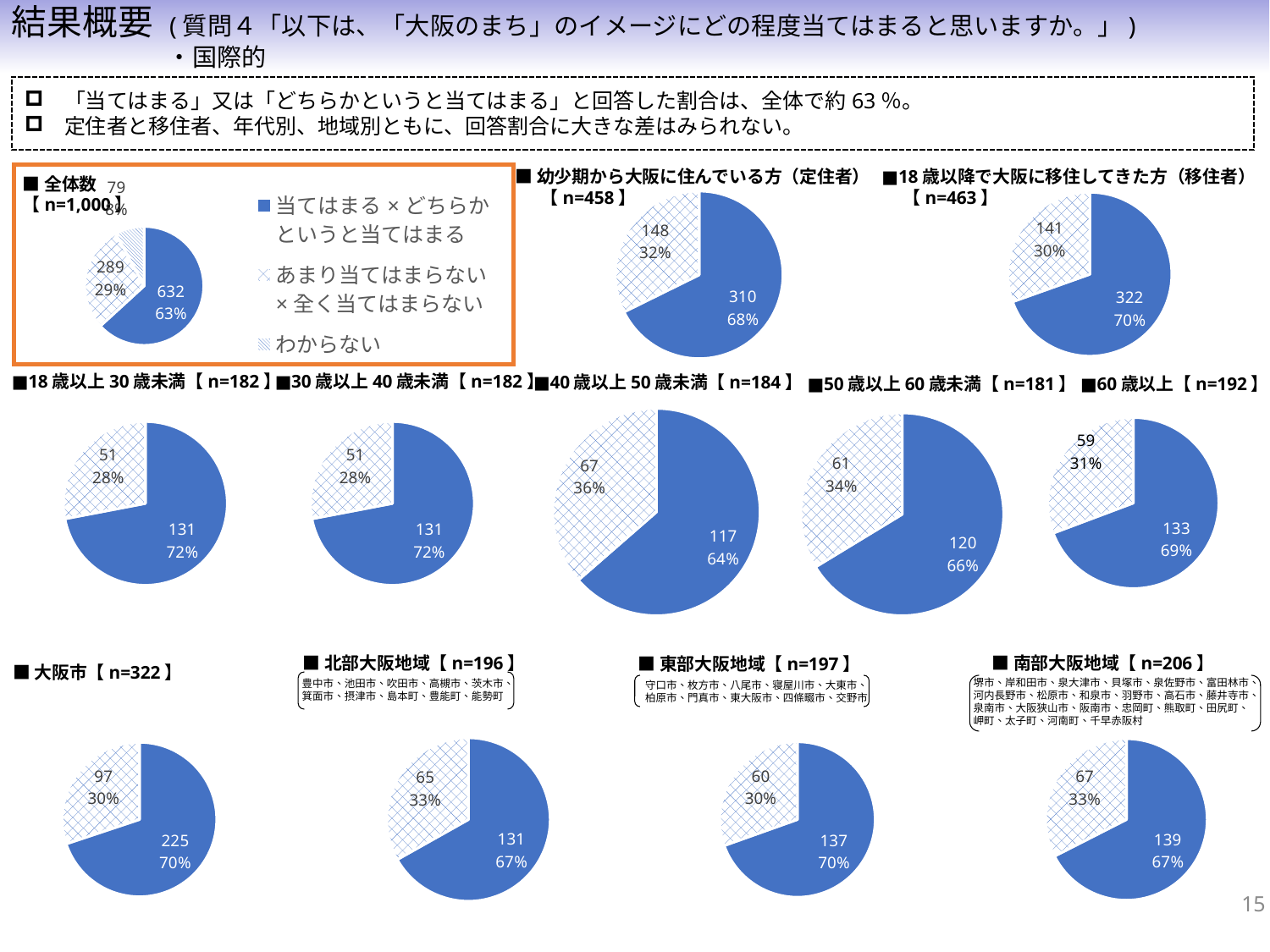
In the 幼少期から大阪に住んでいる方（定住者）【n=458】 pie chart, what percentage is shown for あまり当てはまらない × 全く当てはまらない? 32% What kind of chart is used for the 60歳以上【n=192】 data? Pie chart In the 60歳以上【n=192】 pie chart, which slice is the largest? 当てはまる × どちらかというと当てはまる In the 全体数【n=1,000】 pie chart, what is the count for 当てはまる × どちらかというと当てはまる? 632 In the 40歳以上50歳未満【n=184】 pie chart, what percentage is shown for the 当てはまる × どちらかというと当てはまる slice? 64% In the 南部大阪地域【n=206】 pie chart, what is the count for あまり当てはまらない × 全く当てはまらない? 67 Which pie chart shows the larger 当てはまる × どちらかというと当てはまる percentage: 18歳以上30歳未満【n=182】 or 40歳以上50歳未満【n=184】? 18歳以上30歳未満【n=182】 In the 18歳以降で大阪に移住してきた方（移住者）【n=463】 pie chart, what is the count for 当てはまる × どちらかというと当てはまる? 322 In the 東部大阪地域【n=197】 pie chart, what percentage is shown for 当てはまる × どちらかというと当てはまる? 70% In the 全体数【n=1,000】 pie chart, what percentage share does the わからない slice have? 8% How many entries does the legend next to the 全体数 chart list? 3 In the 大阪市【n=322】 pie chart, what is the difference between the counts of the two slices (225 and 97)? 128